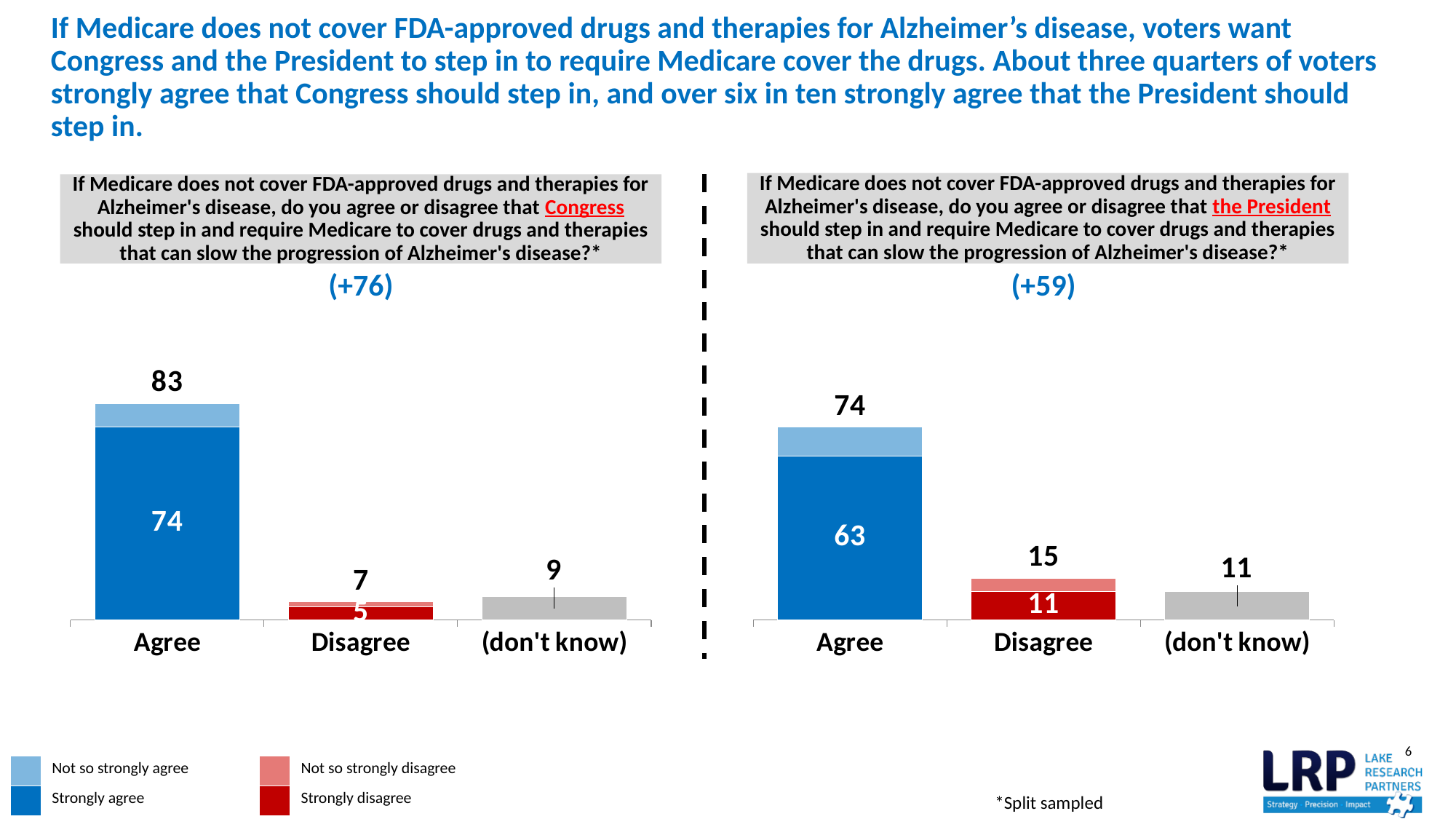
What is the difference between the total Agree value in the Congress chart and the total Agree value in the President chart? 9 Which is larger: the total Disagree value in the Congress chart or the total Disagree value in the President chart? President chart In the President chart on the right, what is the total value shown for Agree? 74 In the Congress chart on the left, what is the difference between the total Disagree value and the Strongly disagree value? 2 How many series does the legend at the bottom of the slide list? 4 In the Congress chart on the left, which category has the lowest total value? Disagree In the President chart on the right, what is the value for Strongly disagree? 11 In the Congress chart on the left, what is the total value shown for Agree? 83 In the President chart on the right, which category has the highest total value? Agree In the Congress chart on the left, what is the value for Strongly agree? 74 How many categories are shown on the x axis of the Congress chart on the left? 3 In the President chart on the right, what is the value for (don't know)? 11